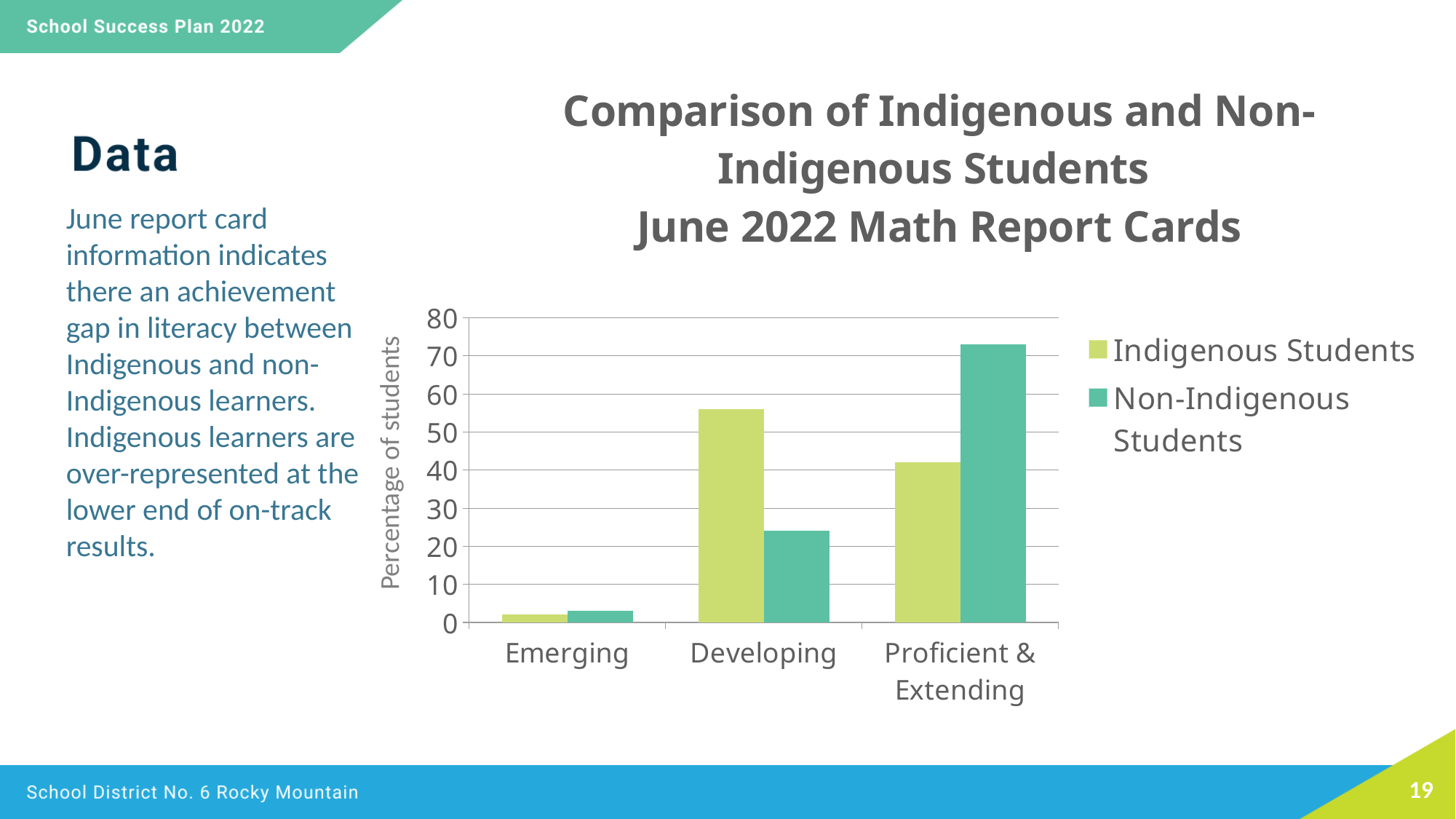
Which category has the highest value for Indigenous Students? Developing Which category has the lowest value for Indigenous Students? Emerging In the Proficient & Extending category, which series has the larger value, Indigenous Students or Non-Indigenous Students? Non-Indigenous Students Which category has the highest value for Non-Indigenous Students? Proficient & Extending How many series does the chart's legend list? 2 Is the value for Non-Indigenous Students in the Proficient & Extending category greater or less than 70? greater What is the title of the chart? Comparison of Indigenous and Non-Indigenous Students June 2022 Math Report Cards What is the label of the vertical axis of the chart? Percentage of students How many categories are shown on the x axis of the chart? 3 Is the value for Non-Indigenous Students in the Developing category greater or less than 30? less What kind of chart is shown on the slide? bar chart In the Developing category, which series has the larger value, Indigenous Students or Non-Indigenous Students? Indigenous Students